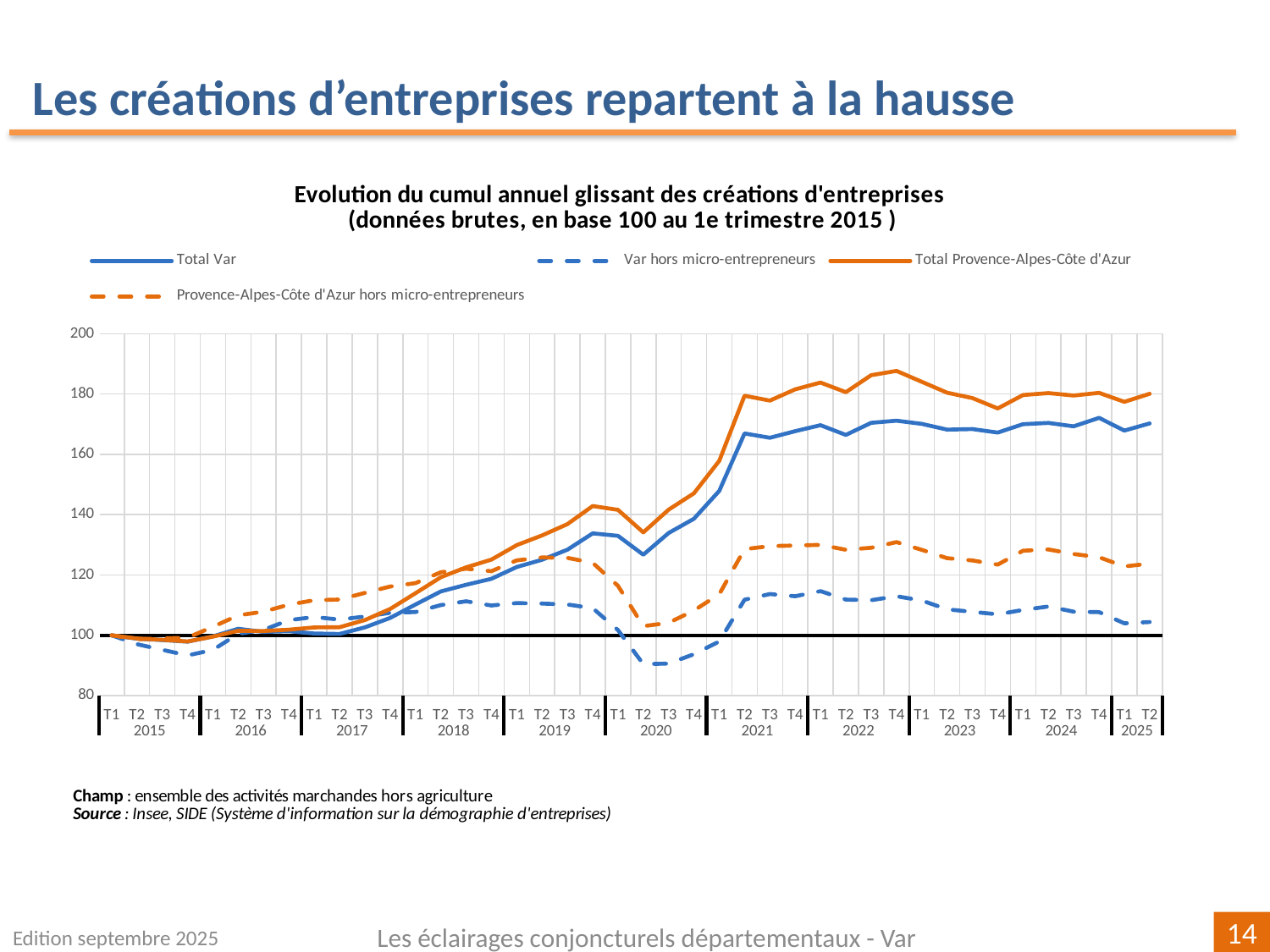
Does the Total Var series rise or fall overall from T1 2015 to T2 2025? rise Which series is drawn as a solid orange line? Total Provence-Alpes-Côte d'Azur What is the title of the chart? Evolution du cumul annuel glissant des créations d'entreprises (données brutes, en base 100 au 1e trimestre 2015 ) Is the value for Provence-Alpes-Côte d'Azur hors micro-entrepreneurs at T4 2022 greater or less than 120? greater Which series has the lowest value at T2 2020? Var hors micro-entrepreneurs What is the value of Total Var at T1 2015? 100 What kind of chart is shown on the slide? line chart How many series does the legend list? 4 Is the value for Var hors micro-entrepreneurs at T2 2020 greater or less than 100? less At T2 2025, which is higher: Total Var or Total Provence-Alpes-Côte d'Azur? Total Provence-Alpes-Côte d'Azur Is the value for Total Provence-Alpes-Côte d'Azur at T4 2022 greater or less than 180? greater